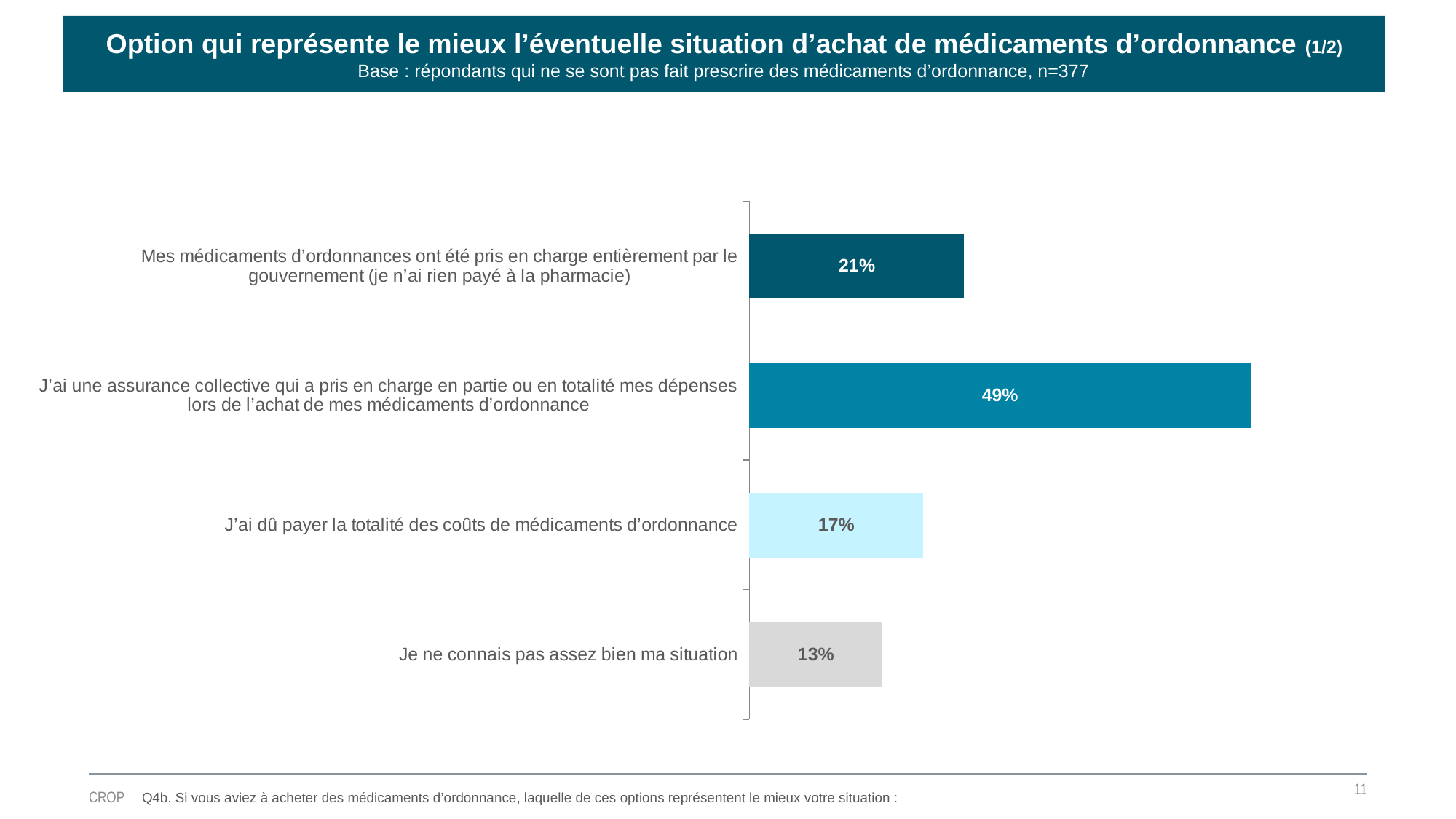
Which is larger: the percentage for government fully covering the drugs or the percentage for paying the full cost? Government fully covering the drugs (21%) What is the base (n) of respondents for this chart? n=377 Which option has the lowest percentage of respondents? Je ne connais pas assez bien ma situation What percentage of respondents said their prescription drugs were fully covered by the government (paid nothing at the pharmacy)? 21% What is the difference in percentage points between the group insurance option and the government fully covered option? 28 What percentage of respondents said they do not know their situation well enough? 13% How many options (categories) are shown in the chart? 4 What percentage of respondents said they have group insurance that covered part or all of their prescription drug expenses? 49% What is the difference in percentage points between 'J'ai dû payer la totalité des coûts de médicaments d'ordonnance' and 'Je ne connais pas assez bien ma situation'? 4 What type of chart is shown on the slide? Bar chart What percentage of respondents said they had to pay the full cost of their prescription drugs? 17% Which option has the highest percentage of respondents? J'ai une assurance collective qui a pris en charge en partie ou en totalité mes dépenses lors de l'achat de mes médicaments d'ordonnance